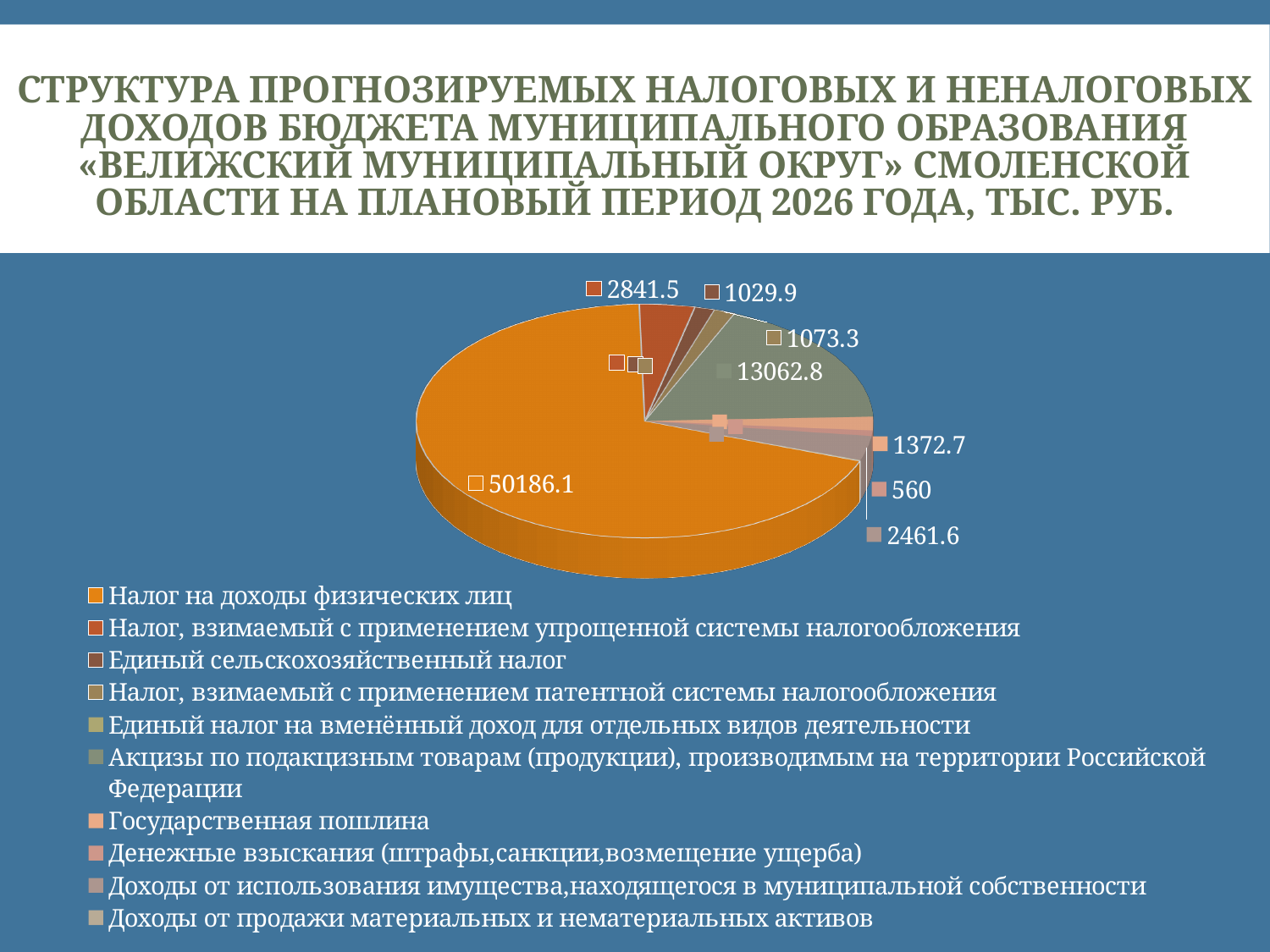
Which is larger: Налог на доходы физических лиц or Акцизы по подакцизным товарам? Налог на доходы физических лиц What kind of chart is shown on the slide? pie chart What is the difference between Акцизы по подакцизным товарам (13062.8) and Налог, взимаемый с применением упрощенной системы налогообложения (2841.5)? 10221.3 What is the smallest value printed as a data label on the chart? 560 What is the value for Налог, взимаемый с применением упрощенной системы налогообложения? 2841.5 What is the difference between Налог на доходы физических лиц (50186.1) and Акцизы по подакцизным товарам (13062.8)? 37123.3 In what units are the values on the chart given, according to the title? тыс. руб. Which category has the largest slice of the pie? Налог на доходы физических лиц How many categories does the legend list? 10 What is the value for Налог на доходы физических лиц? 50186.1 What is the value for Акцизы по подакцизным товарам (продукции), производимым на территории Российской Федерации? 13062.8 Which year does the chart's title say the forecast is for? 2026